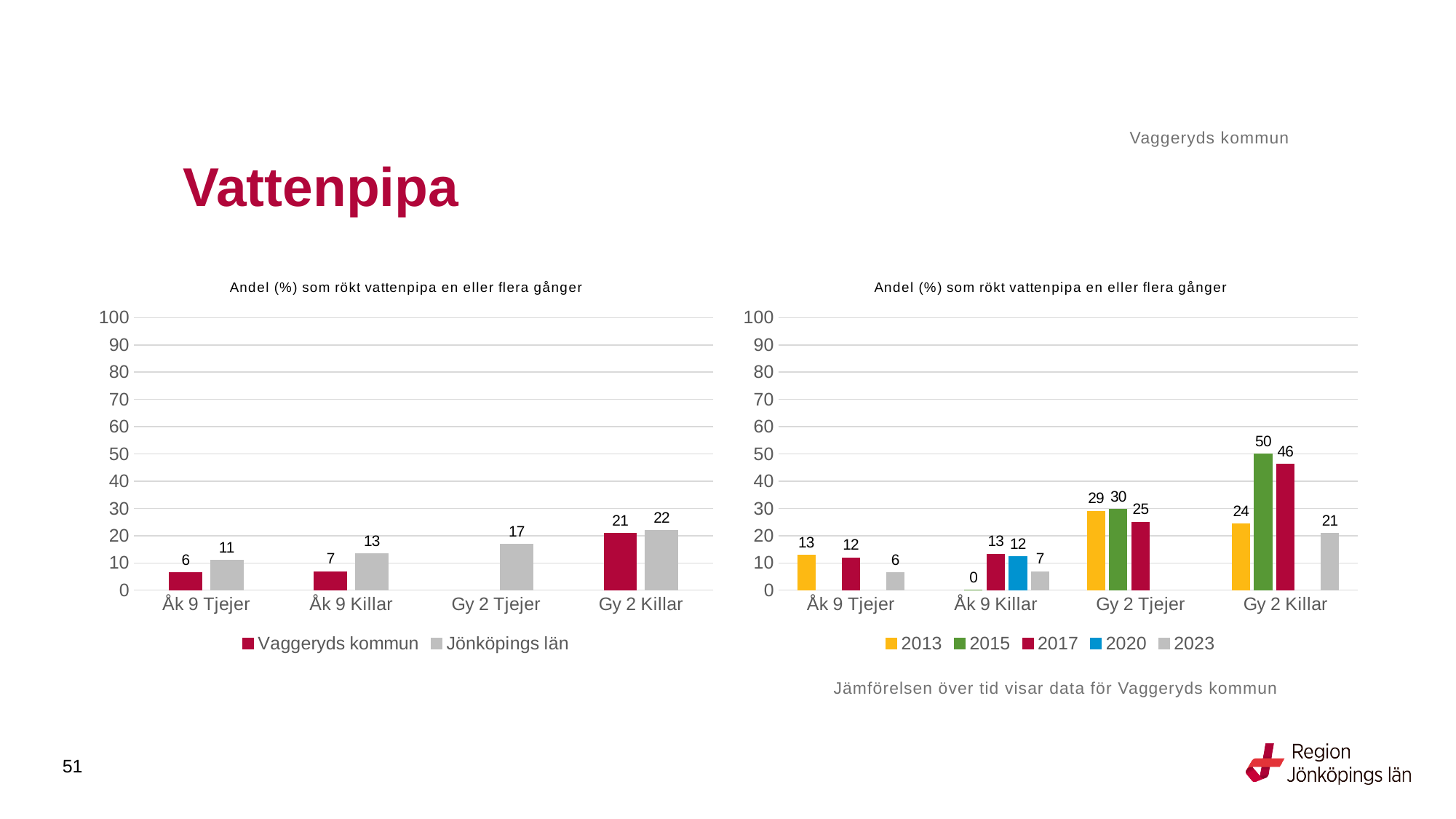
What kind of chart is the left chart? Bar chart In the right chart, what is the value for 2015 for Gy 2 Killar? 50 In the left chart, how many series does the legend list? 2 In the right chart, is the 2013 value for Gy 2 Tjejer larger or smaller than the 2017 value for Gy 2 Tjejer? Larger In the right chart, what is the value for 2020 for Åk 9 Killar? 12 In the left chart, what is the value for Vaggeryds kommun for Gy 2 Killar? 21 In the right chart, how many series does the legend list? 5 In the right chart, what is the difference between the 2015 and 2017 values for Gy 2 Killar? 4 In the left chart, what is the difference between Jönköpings län and Vaggeryds kommun for Åk 9 Killar? 6 In the left chart, which category has the highest value for Jönköpings län? Gy 2 Killar In the right chart, which year has the lowest value for Gy 2 Killar? 2023 In the left chart, what is the value for Jönköpings län for Gy 2 Tjejer? 17